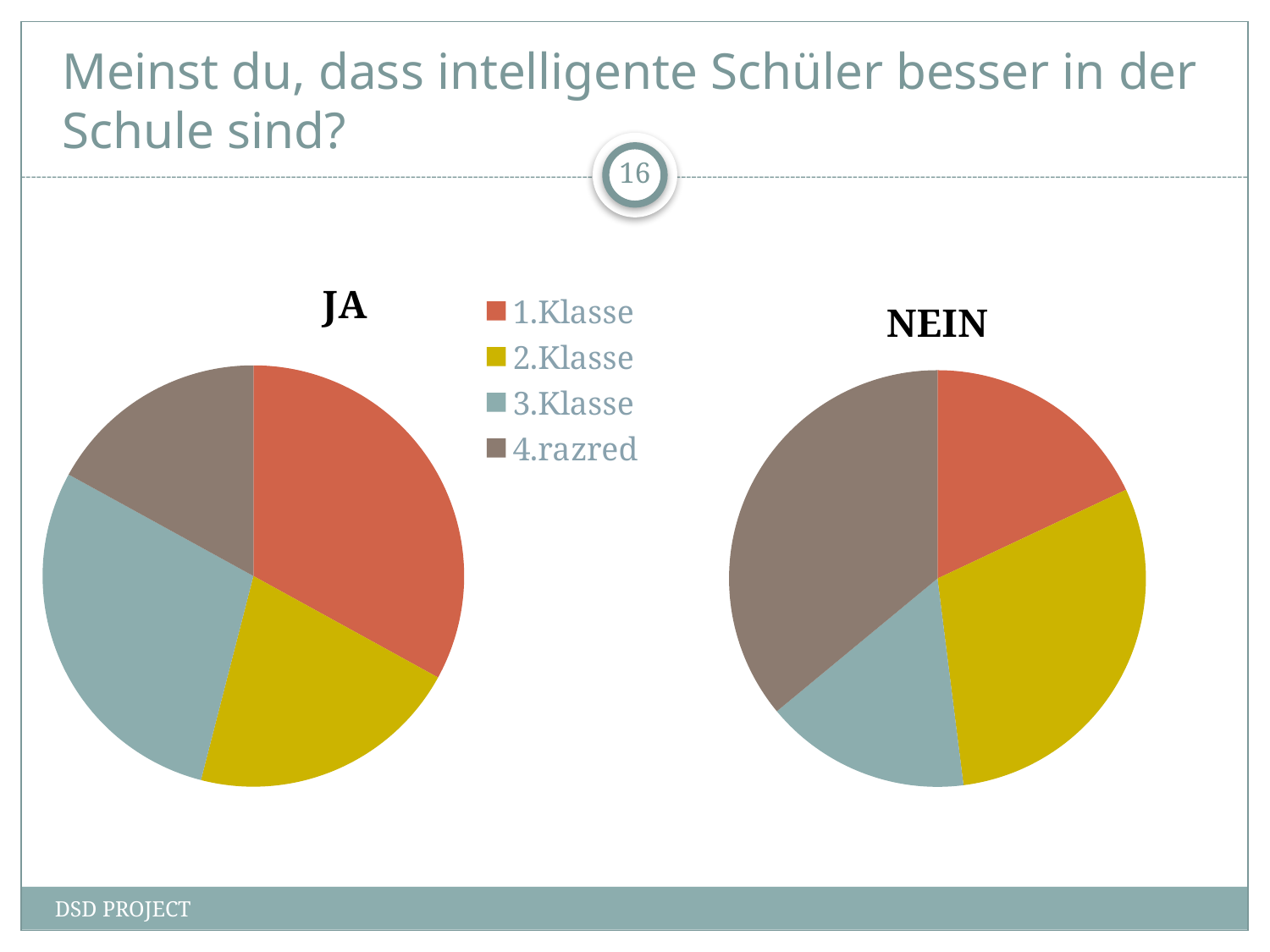
In the "NEIN" pie chart, which slice is larger, 2.Klasse or 3.Klasse? 2.Klasse What kind of chart is the "JA" chart? pie chart What kind of chart is the "NEIN" chart? pie chart In the "NEIN" pie chart, which slice is larger, 4.razred or 1.Klasse? 4.razred How many slices does the "NEIN" pie chart have? 4 How many slices does the "JA" pie chart have? 4 What are the four categories listed in the legend? 1.Klasse, 2.Klasse, 3.Klasse, 4.razred In the "JA" pie chart, which slice is larger, 1.Klasse or 2.Klasse? 1.Klasse In the "JA" pie chart, which category has the smallest slice? 4.razred In the "JA" pie chart, which category has the largest slice? 1.Klasse What is the title of the pie chart on the right of the slide? NEIN How many entries does the legend list? 4